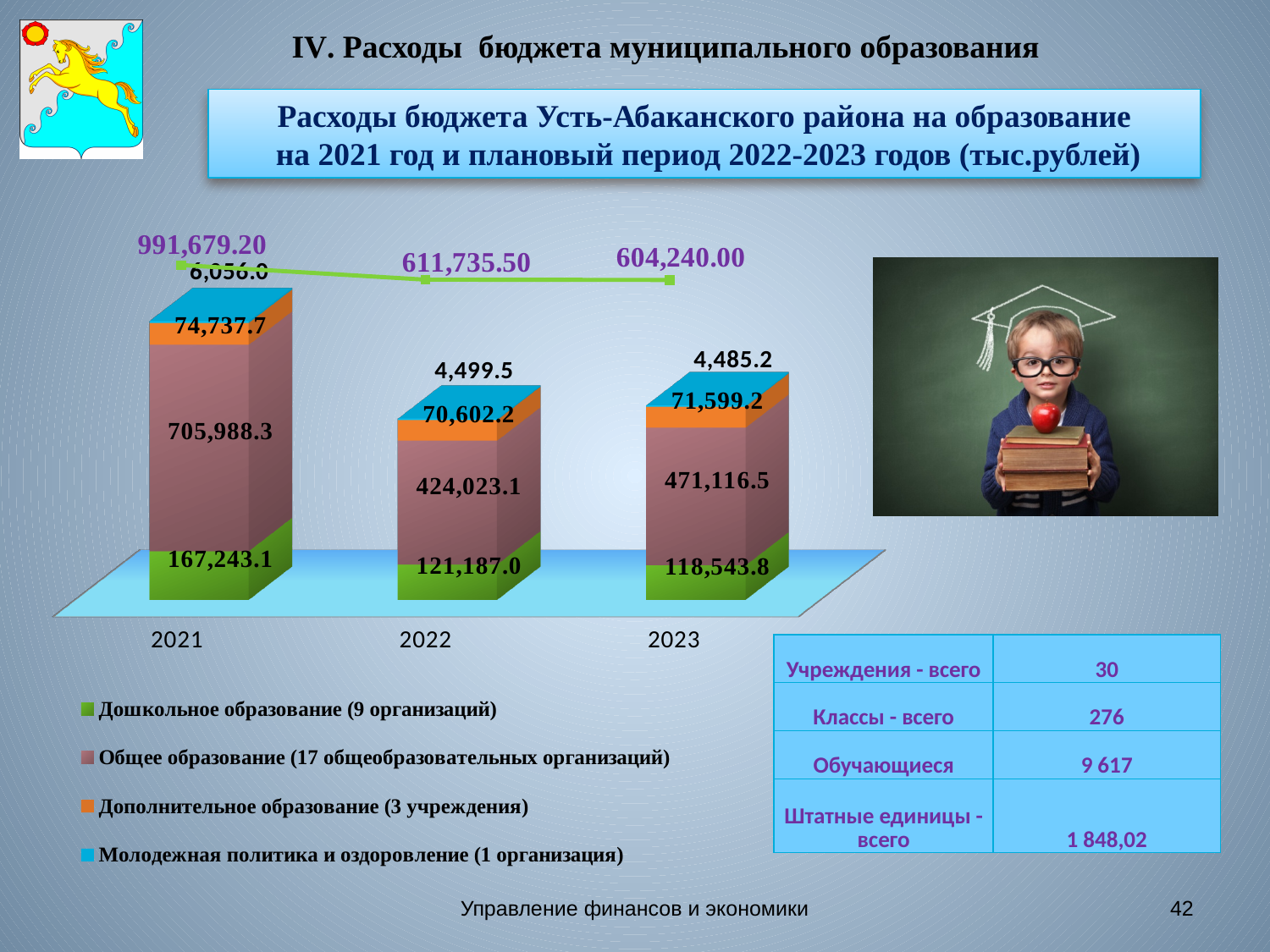
Does the value for Дошкольное образование rise or fall from 2021 to 2023? Fall In which year is the value for Общее образование the highest? 2021 What total value is printed above the 2023 bar on the line? 604,240.00 In which year is the value for Дошкольное образование the lowest? 2023 How many series does the chart legend list? 4 What is the difference between the Дошкольное образование values for 2021 and 2022? 46,056.1 What is the value for Дополнительное образование in 2021? 74,737.7 What is the value for Дошкольное образование in 2023? 118,543.8 What is the value for Общее образование in 2022? 424,023.1 How many years are shown on the x axis of the chart? 3 What is the value for Молодежная политика и оздоровление in 2022? 4,499.5 What kind of chart is shown on the slide? Stacked bar chart